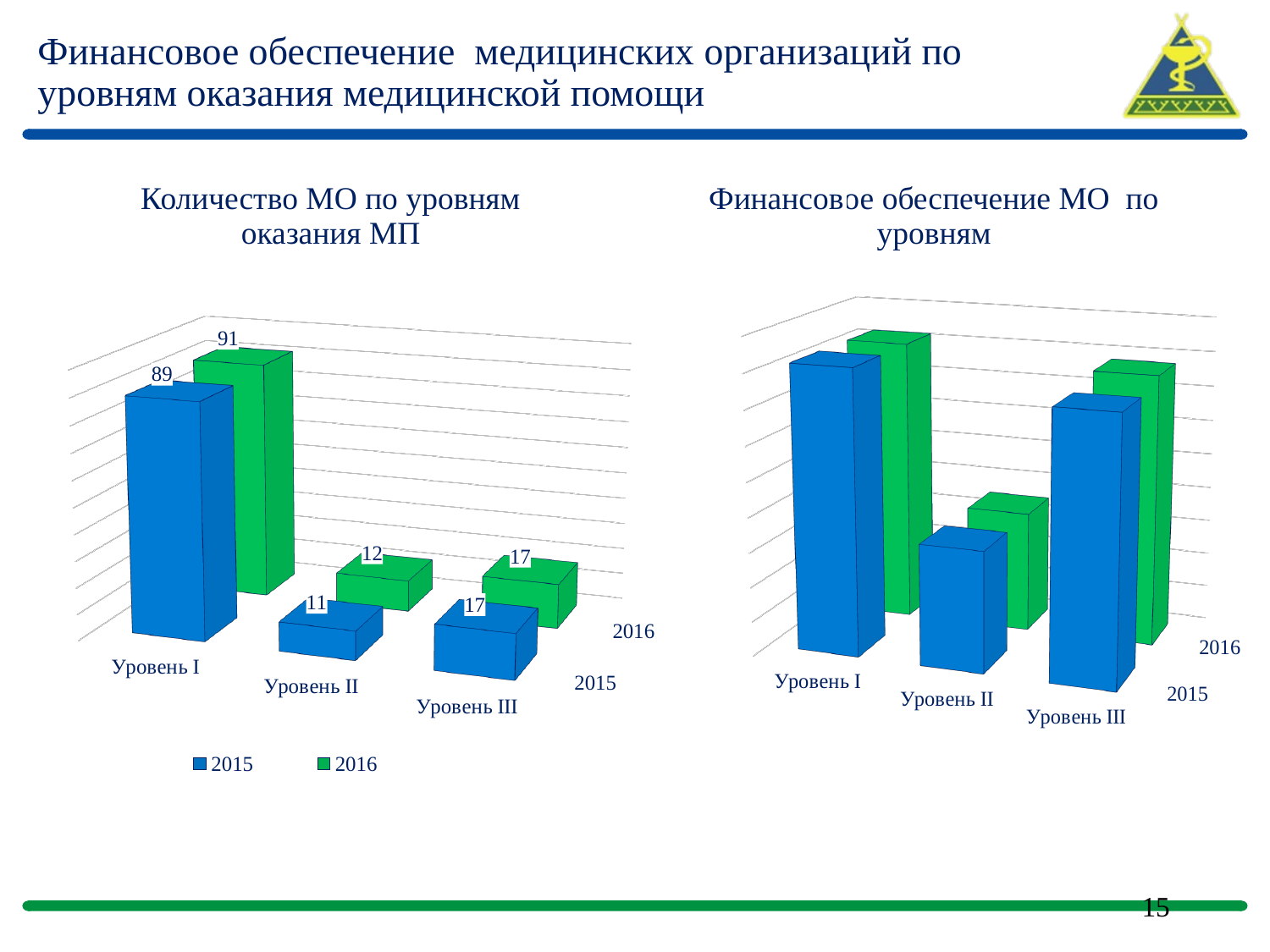
In the chart 'Финансовое обеспечение МО по уровням', which is larger in 2016: Уровень I or Уровень II? Уровень I In the chart 'Количество МО по уровням оказания МП', what is the value for Уровень I in 2015? 89 In the chart 'Количество МО по уровням оказания МП', what is the value for Уровень I in 2016? 91 In the chart 'Количество МО по уровням оказания МП', which level has the lowest value in 2015? Уровень II In the chart 'Количество МО по уровням оказания МП', which level has the highest value in 2016? Уровень I In the chart 'Количество МО по уровням оказания МП', how many series does the legend list? 2 In the chart 'Количество МО по уровням оказания МП', what is the value for Уровень III in 2015? 17 In the chart 'Количество МО по уровням оказания МП', how many levels (categories) are shown? 3 In the chart 'Финансовое обеспечение МО по уровням', which level has the lowest value in 2015? Уровень II In the chart 'Количество МО по уровням оказания МП', what is the difference between the 2016 and 2015 values for Уровень I? 2 What kind of chart is 'Финансовое обеспечение МО по уровням'? Bar chart In the chart 'Количество МО по уровням оказания МП', what is the value for Уровень II in 2016? 12